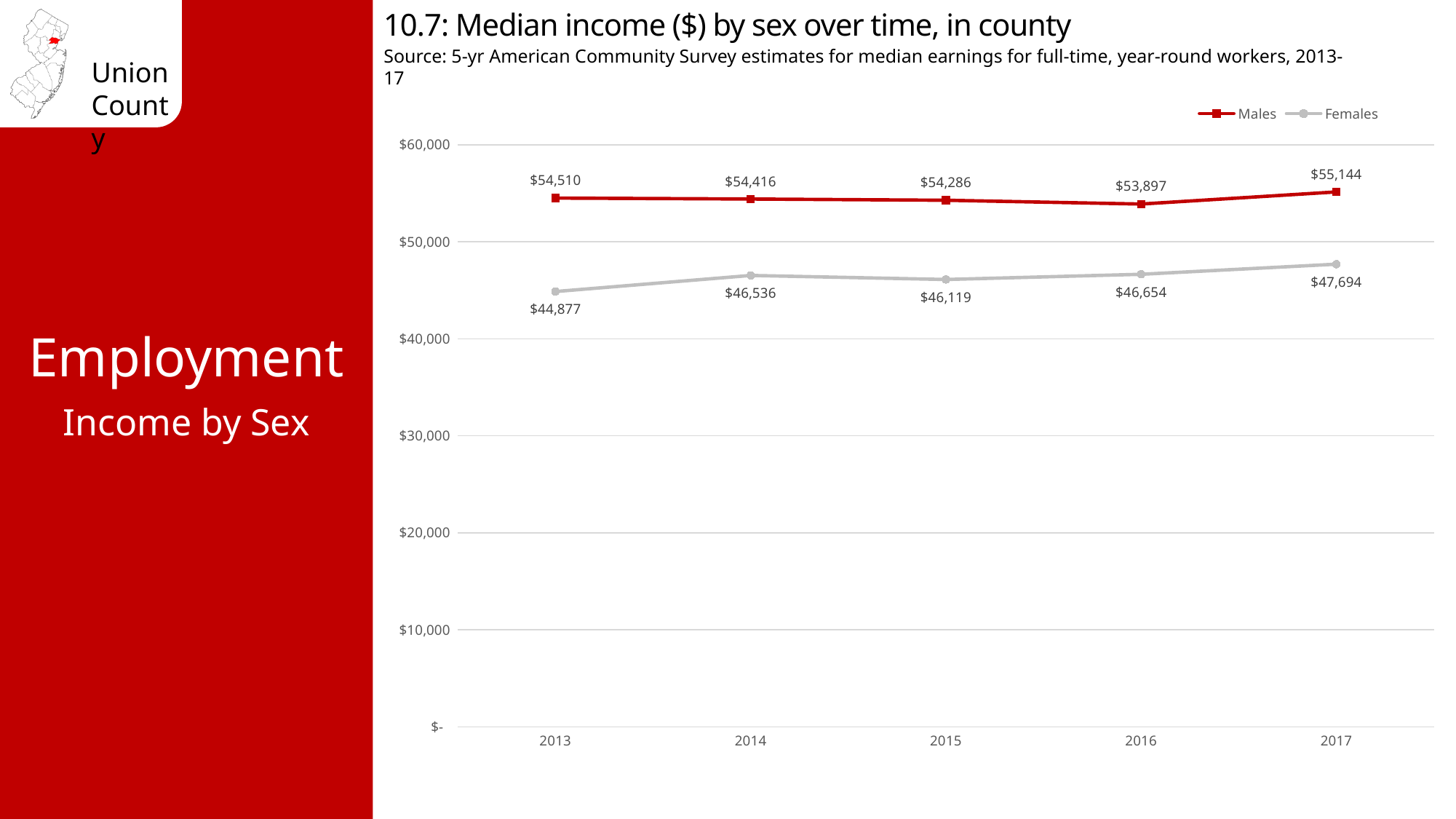
What was the median income for Males in 2013? $54,510 In which year was the median income for Males highest? 2017 What is the difference between the Males and Females median income in 2016? $7,243 How many years are shown on the x axis? 5 In which year was the median income for Females lowest? 2013 Which series had the higher median income in 2014, Males or Females? Males What was the median income for Females in 2015? $46,119 Is the median income for Females in 2013 greater or less than $50,000? less What colour is the line for Males? red How many series does the legend list? 2 What kind of chart is shown on the slide? line chart What was the median income for Females in 2017? $47,694